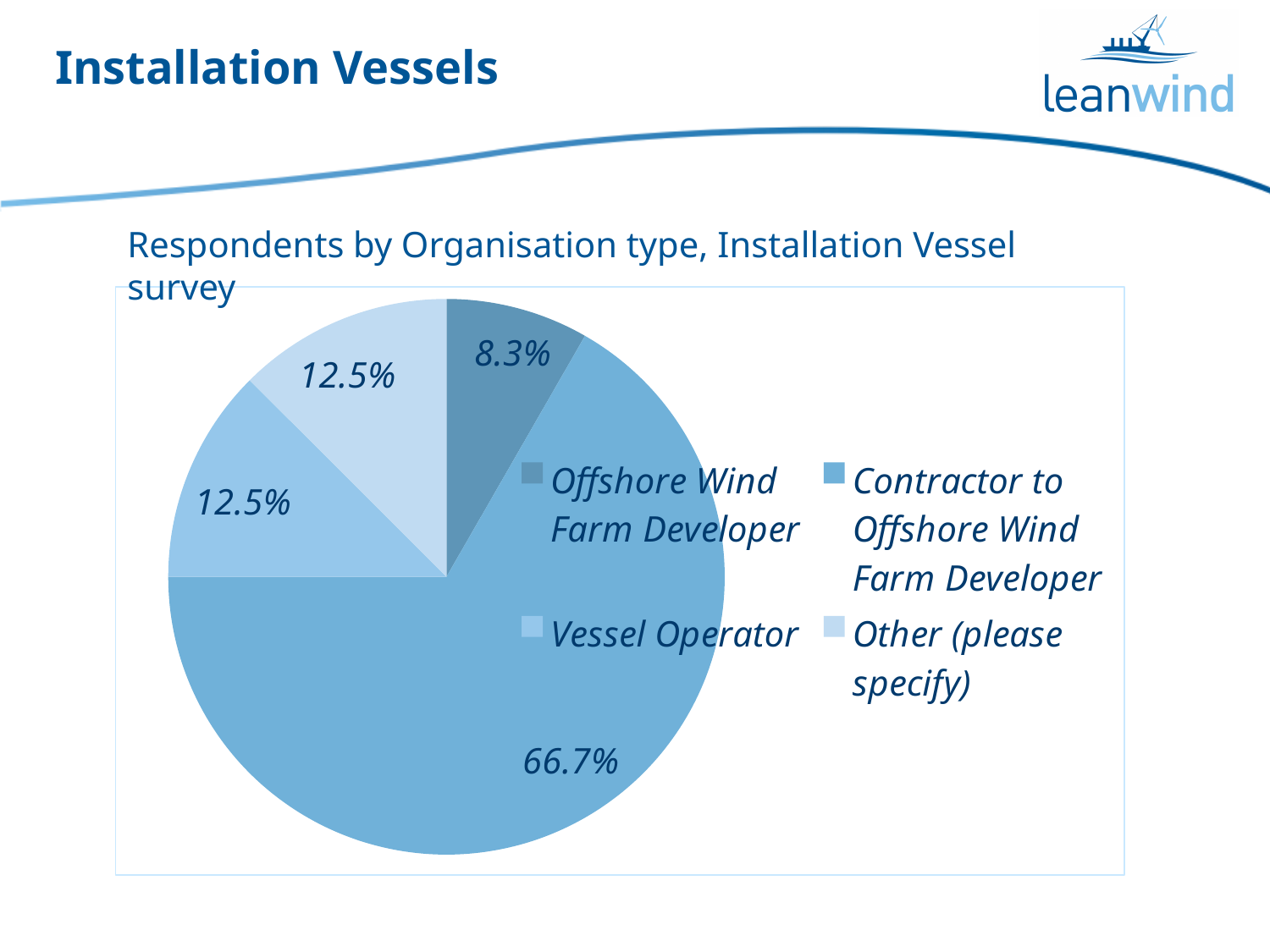
What share of respondents fall under Other (please specify)? 12.5% How many organisation types are shown in the pie chart? 4 Which is larger, the share for Vessel Operator or the share for Offshore Wind Farm Developer? Vessel Operator What kind of chart is shown on the slide? Pie chart Which organisation type has the largest share of respondents? Contractor to Offshore Wind Farm Developer What share of respondents are Vessel Operators? 12.5% What is the title of the chart? Respondents by Organisation type, Installation Vessel survey What is the difference in percentage points between the Contractor to Offshore Wind Farm Developer share and the Offshore Wind Farm Developer share? 58.4 percentage points What share of respondents are Contractors to Offshore Wind Farm Developers? 66.7% Which organisation type has the smallest share of respondents? Offshore Wind Farm Developer How many entries does the legend list? 4 What share of respondents are Offshore Wind Farm Developers? 8.3%